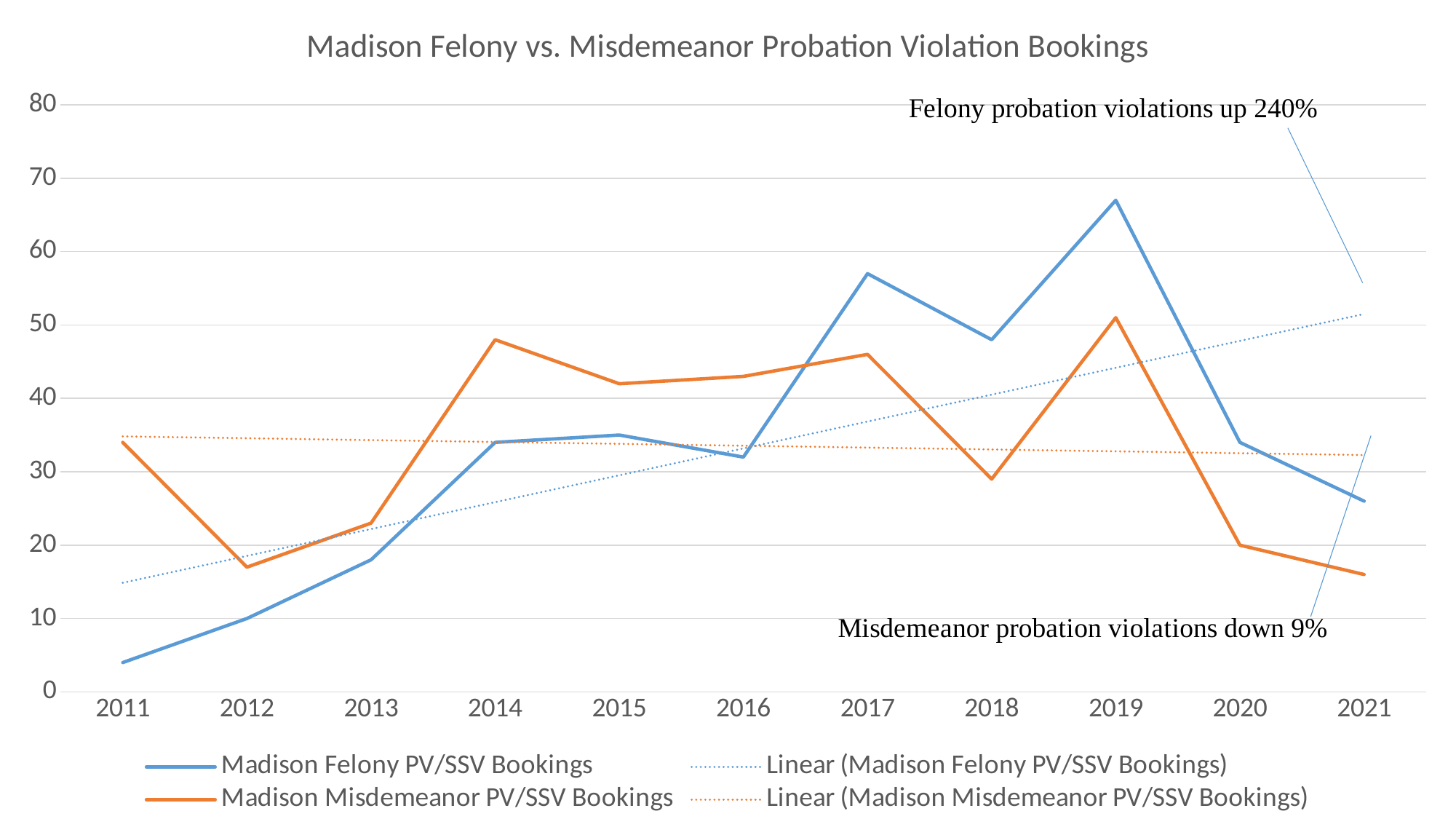
What kind of chart is shown on the slide? Line chart Is the value for Madison Misdemeanor PV/SSV Bookings in 2021 greater or less than 20? less Is the value for Madison Felony PV/SSV Bookings in 2011 greater or less than 10? less What is the title of the chart? Madison Felony vs. Misdemeanor Probation Violation Bookings How many entries does the chart's legend list? 4 In which year do Madison Felony PV/SSV Bookings reach their highest value? 2019 How many years are shown on the x axis? 11 Is the value for Madison Felony PV/SSV Bookings in 2019 greater or less than 60? greater In which year are Madison Felony PV/SSV Bookings lowest? 2011 In 2011, which series has the larger value: Madison Felony PV/SSV Bookings or Madison Misdemeanor PV/SSV Bookings? Madison Misdemeanor PV/SSV Bookings In which year do Madison Misdemeanor PV/SSV Bookings reach their highest value? 2019 According to the annotation on the chart, by what percentage are felony probation violations up? 240%